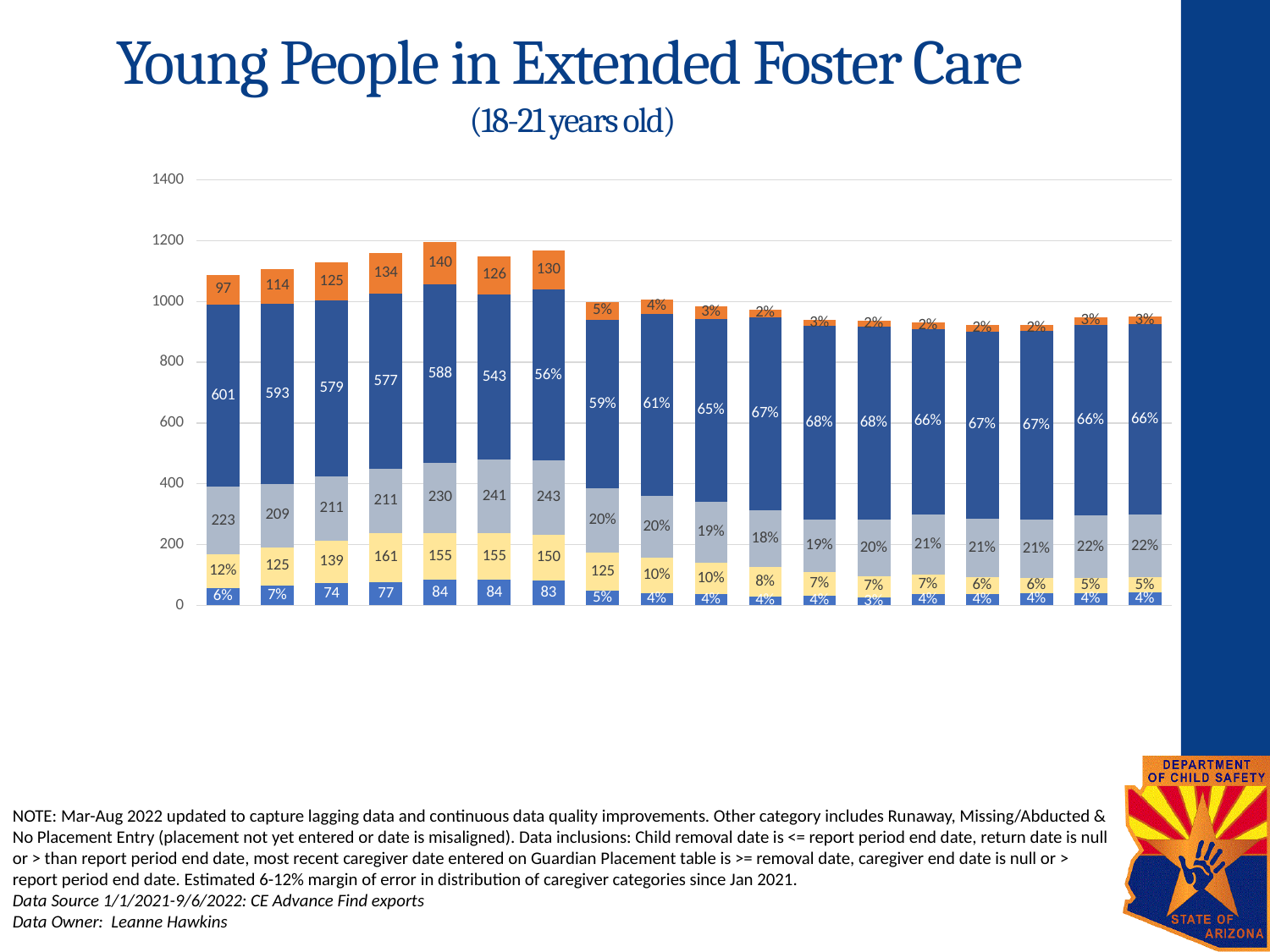
What is the value of the grey segment of the seventh bar from the left? 243 Is the total height of the rightmost bar greater or less than 1000? less What is the value of the dark blue segment of the fifth bar from the left? 588 What kind of chart is shown on the slide? stacked bar chart How many bars are plotted in the chart? 18 What is the value of the yellow segment of the fourth bar from the left? 161 Is the total height of the leftmost bar greater or less than 1000? greater What is the value of the orange (top) segment of the leftmost bar? 97 What age range is given in the chart's subtitle? 18-21 years old Which is larger: the dark blue segment of the fifth bar (588) or of the sixth bar (543)? the fifth bar, 588 Among the orange segments with numeric labels, which bar has the highest value, and what is it? the fifth bar from the left, 140 What is the difference between the dark blue segment values of the first bar (601) and the second bar (593)? 8